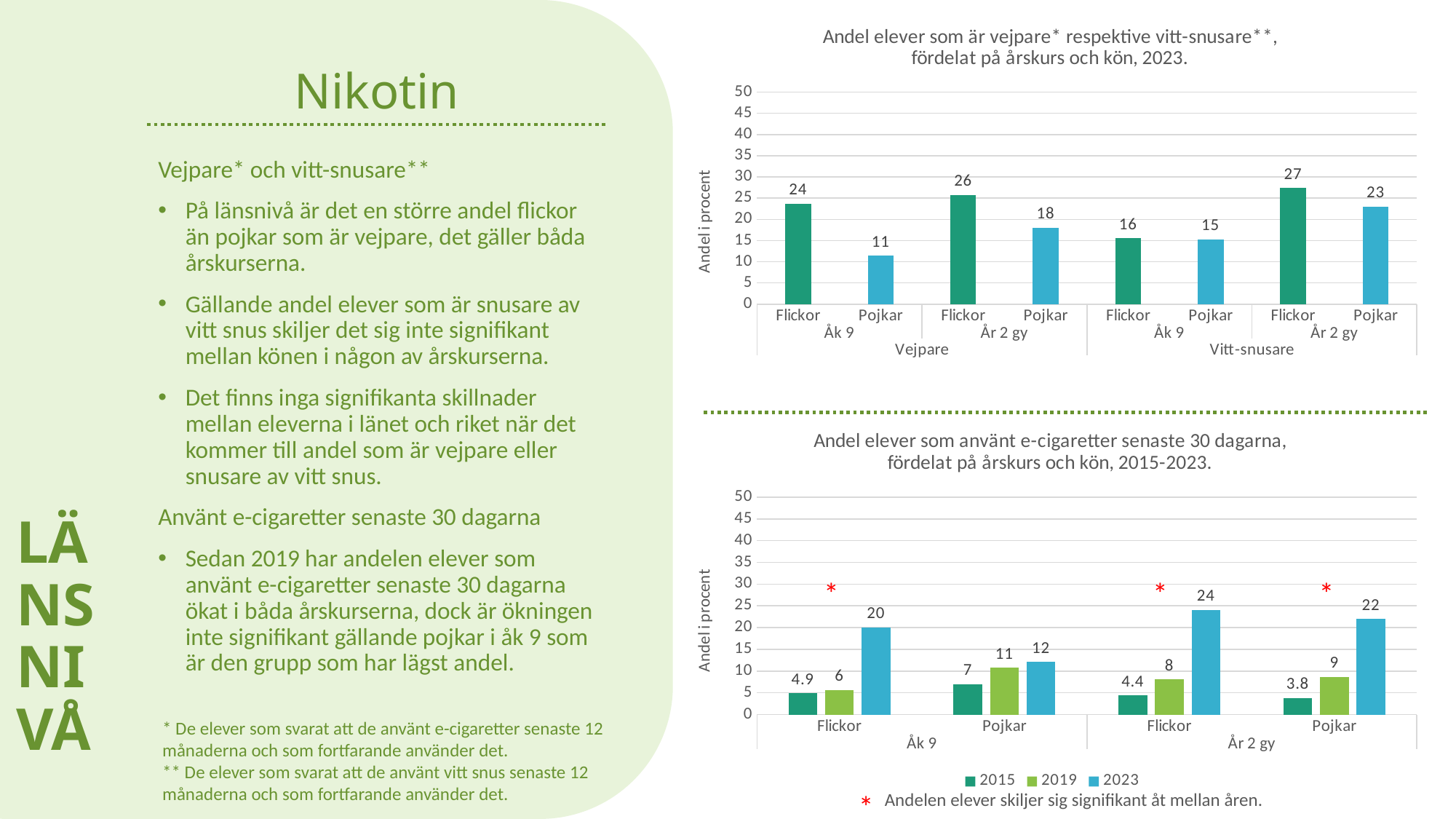
In the top chart (vejpare/vitt-snusare 2023), how many bars are plotted? 8 What kind of chart is the bottom chart (e-cigaretter 2015-2023)? bar chart In the top chart (vejpare/vitt-snusare 2023), what is the value for Flickor in Åk 9 under Vejpare? 24 In the top chart (vejpare/vitt-snusare 2023), what is the difference between Flickor and Pojkar in Åk 9 under Vejpare? 13 In the bottom chart (e-cigaretter 2015-2023), what is the 2023 value for Flickor in År 2 gy? 24 In the bottom chart (e-cigaretter 2015-2023), do the values for Flickor in Åk 9 rise or fall from 2015 to 2023? rise In the bottom chart (e-cigaretter 2015-2023), how many series does the legend list? 3 In the top chart (vejpare/vitt-snusare 2023), which bar has the highest value? Flickor, År 2 gy, Vitt-snusare (27) In the bottom chart (e-cigaretter 2015-2023), which is larger: the 2023 value for Pojkar in Åk 9 or the 2023 value for Pojkar in År 2 gy? Pojkar in År 2 gy (22) In the bottom chart (e-cigaretter 2015-2023), what is the 2015 value for Pojkar in År 2 gy? 3.8 In the top chart (vejpare/vitt-snusare 2023), which bar has the lowest value? Pojkar, Åk 9, Vejpare (11) In the top chart (vejpare/vitt-snusare 2023), what is the value for Pojkar in År 2 gy under Vitt-snusare? 23